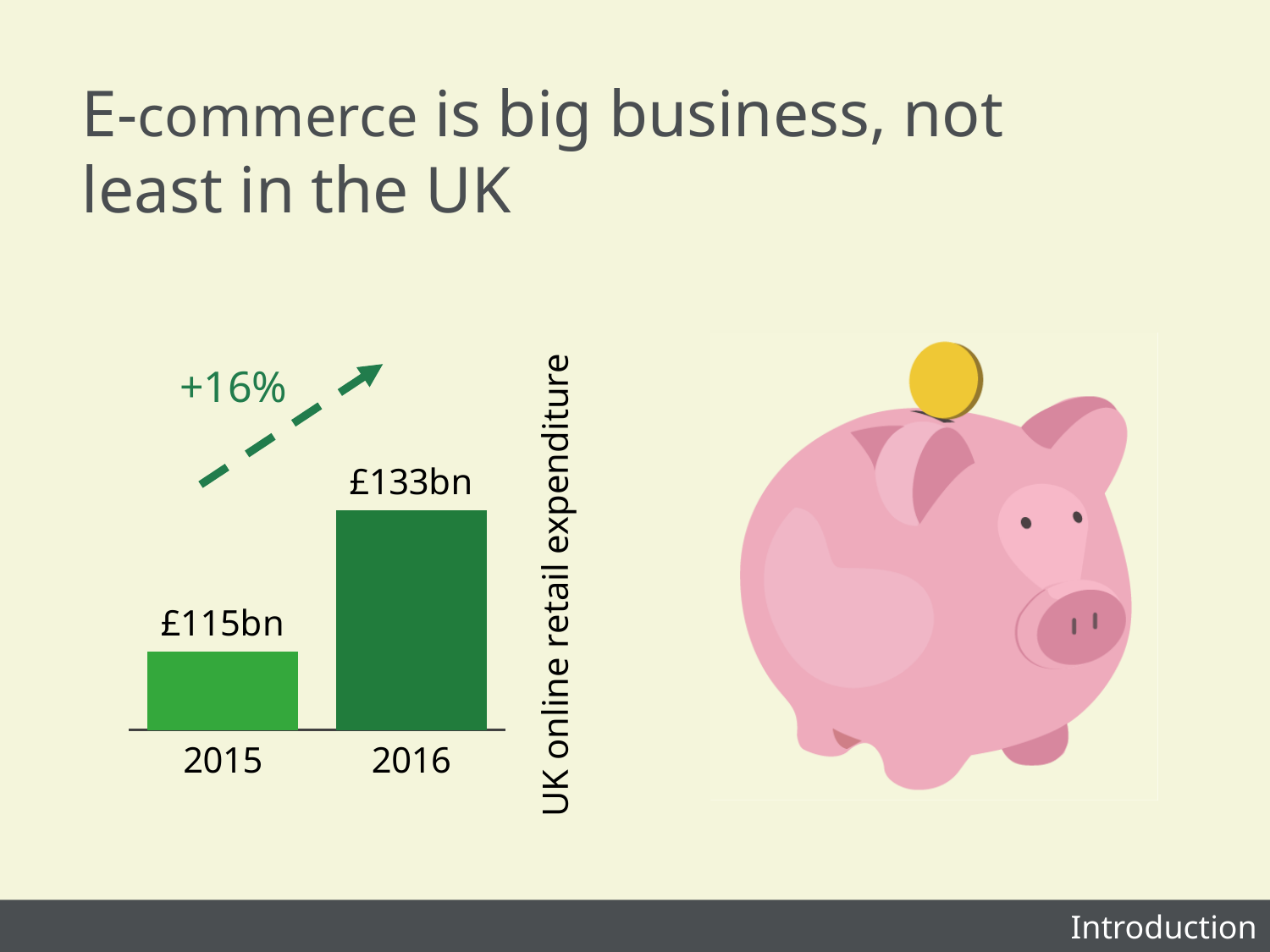
By how much did UK online retail expenditure increase from 2015 to 2016? £18bn Which year has the higher UK online retail expenditure? 2016 Is the value for 2016 larger or smaller than the value for 2015? larger Does UK online retail expenditure rise or fall from 2015 to 2016? rise What kind of chart is shown on the slide? bar chart What percentage growth is annotated above the bars? +16% How many years are shown in the chart? 2 What is the UK online retail expenditure for 2016? £133bn Which year has the lower UK online retail expenditure? 2015 What is the UK online retail expenditure for 2015? £115bn What is the label on the vertical axis of the chart? UK online retail expenditure